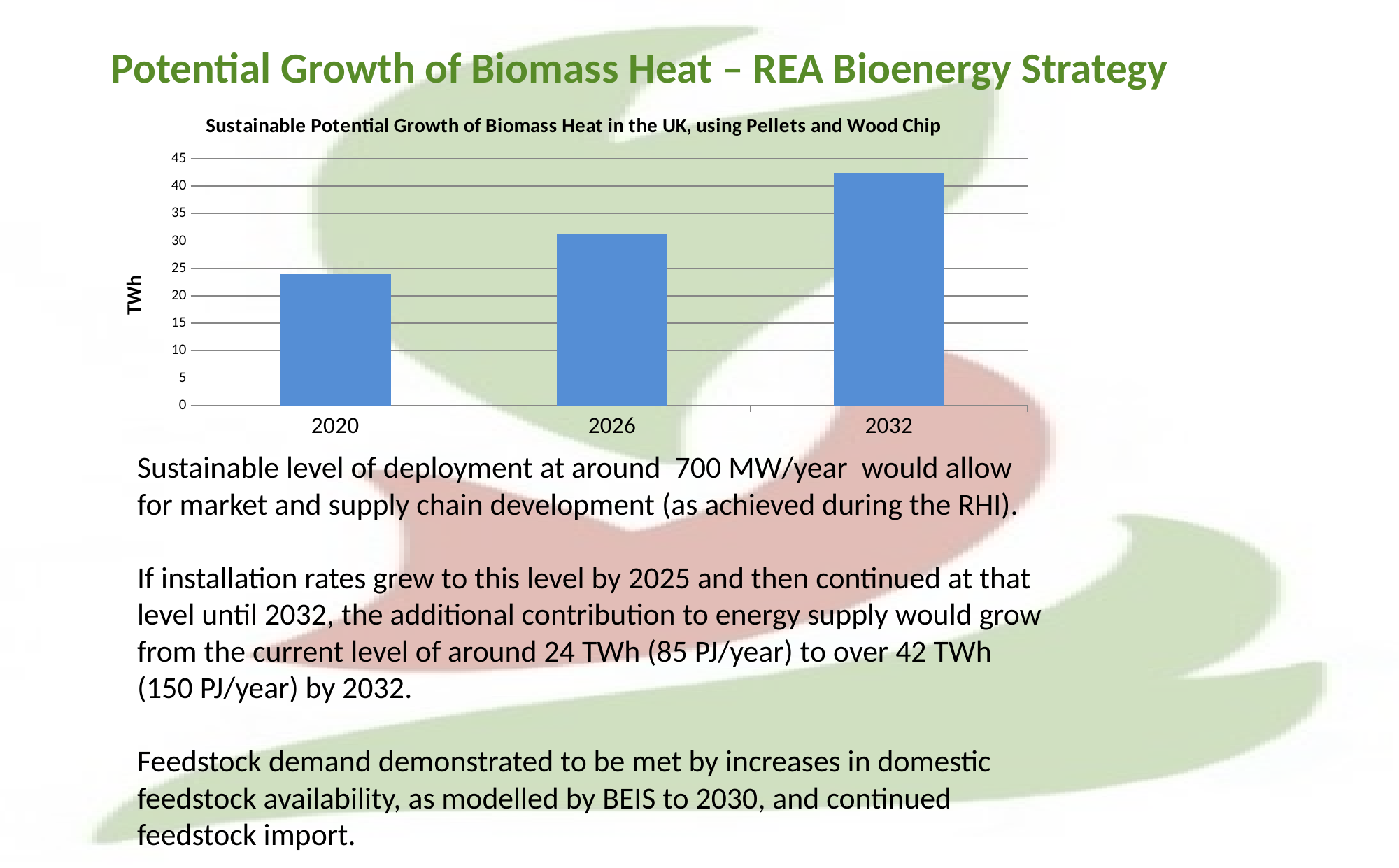
Which is larger, the value for 2026 or the value for 2032? 2032 How many bars (years) are plotted in the chart? 3 Which year has the lowest value in the chart? 2020 Do the values rise or fall from 2020 to 2032? rise Is the value for 2026 greater or less than 30? greater What is the title of the chart? Sustainable Potential Growth of Biomass Heat in the UK, using Pellets and Wood Chip Which year has the highest value in the chart? 2032 Is the value for 2032 greater or less than 40? greater Is the value for 2020 greater or less than 25? less What kind of chart is shown on the slide? bar chart What unit is shown on the vertical axis of the chart? TWh